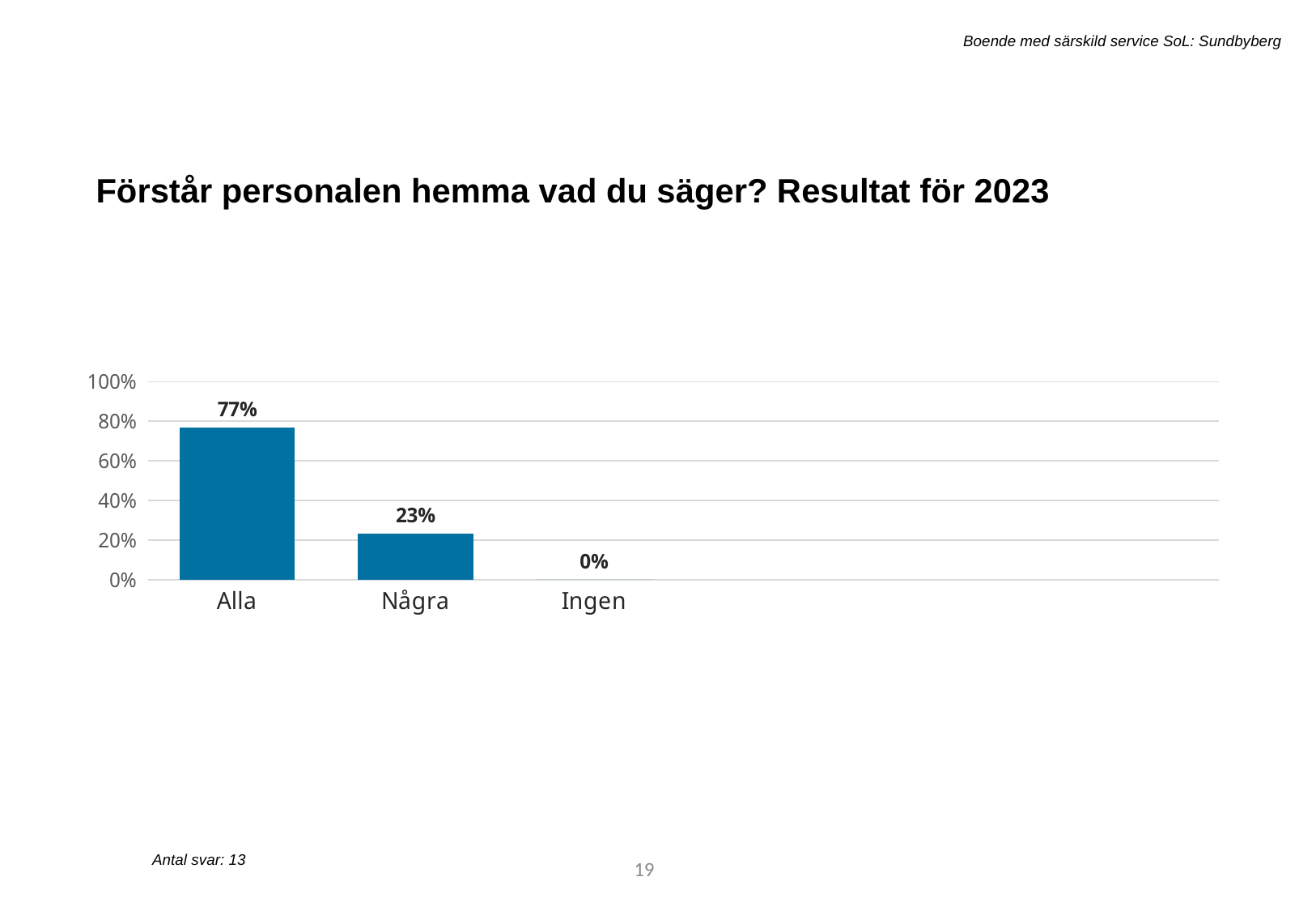
Which is larger, the value for Alla or the value for Några? Alla What kind of chart is shown on the slide? bar chart Is the value for Några greater or less than 40%? less Is the value for Alla greater or less than 60%? greater What is the value for Några? 23% What is the difference between the values for Alla and Några? 54% What is the value for Alla? 77% Which category has the highest value? Alla Which category has the lowest value? Ingen What is the value for Ingen? 0% How many categories are shown on the x axis? 3 What is the title of the chart? Förstår personalen hemma vad du säger? Resultat för 2023